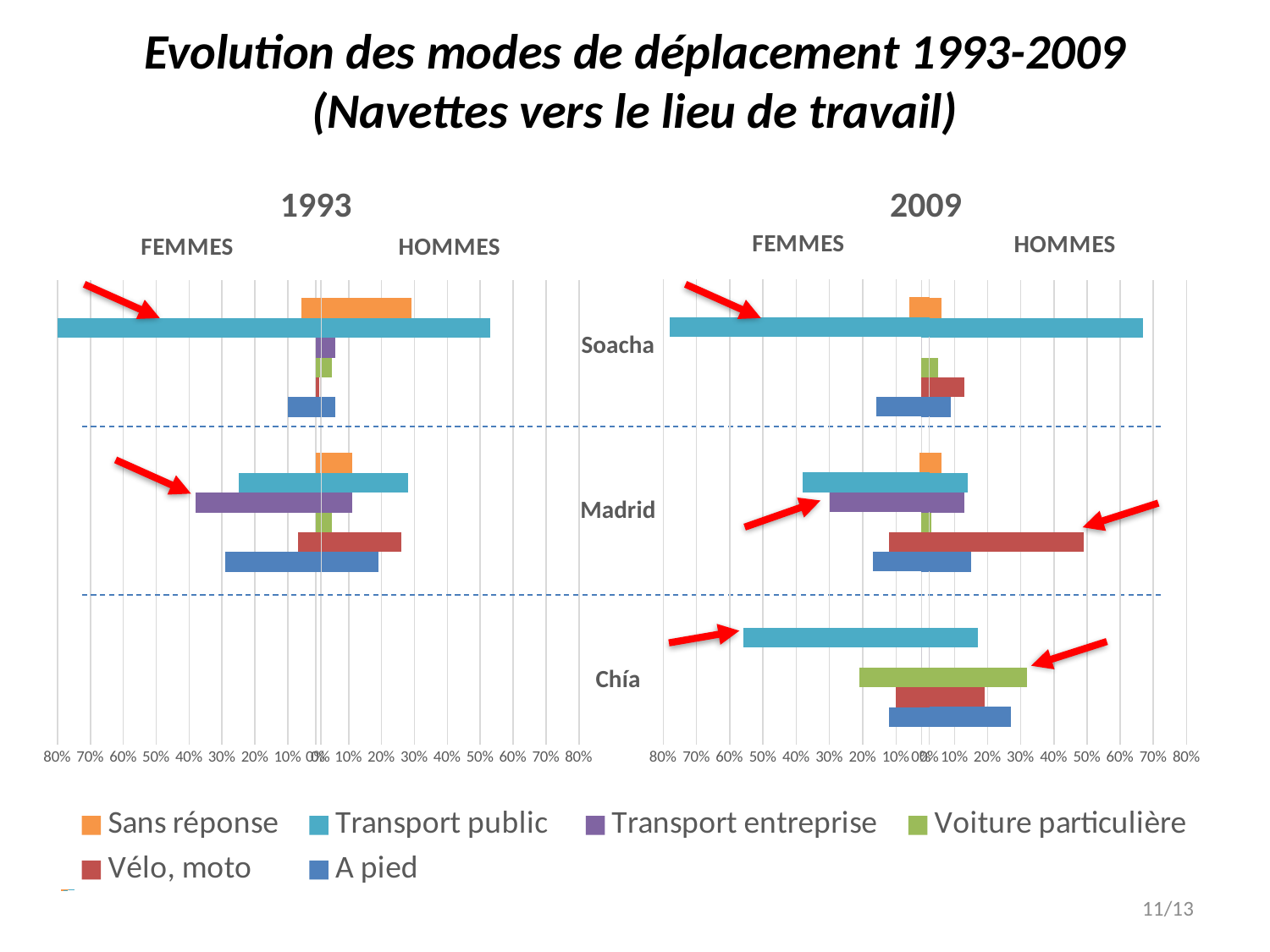
In the 2009 chart, is the Transport public value for Hommes in Soacha greater or less than 60%? greater How many series does the shared legend list? 6 What kind of chart is the 1993 chart on the left? bar chart In the 1993 chart, is the Transport entreprise value for Femmes in Madrid greater or less than 30%? greater In the 1993 chart, is the Transport public value for Hommes in Soacha greater or less than 40%? greater How many cities are labelled between the two charts? 3 In the 1993 chart, which city has no bars plotted? Chía In the 1993 chart, which is larger for Transport public in Soacha: the Femmes value or the Hommes value? Femmes In the 2009 chart, which mode has the longest bar for Hommes in Madrid? Vélo, moto